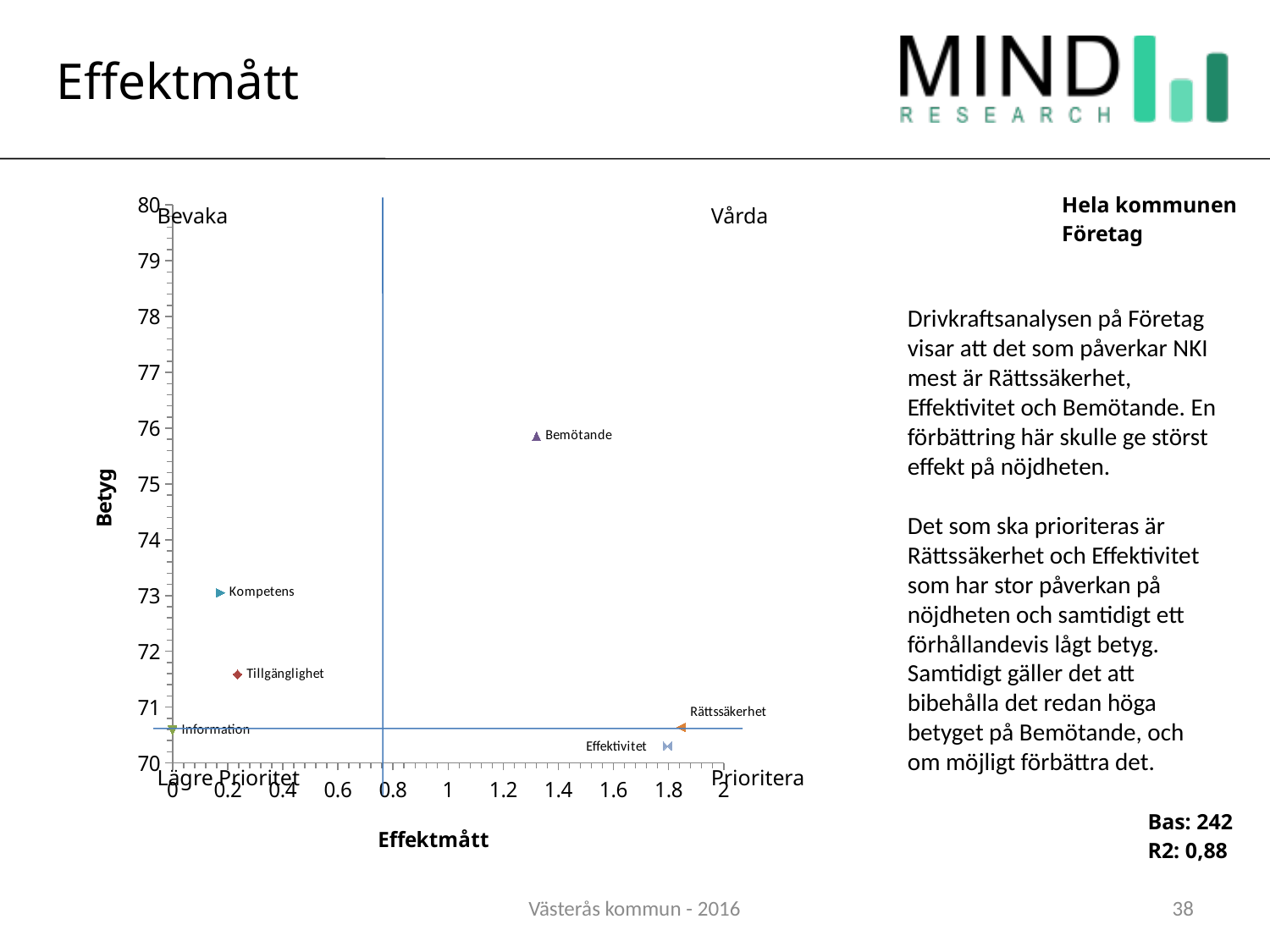
What label appears in the top-right quadrant of the chart? Vårda Is the Betyg value for Kompetens greater or less than 72? greater What is the title of the horizontal axis of the chart? Effektmått How many data points are plotted in the chart? 6 Which has a higher Betyg value, Bemötande or Kompetens? Bemötande Is the Betyg value for Bemötande greater or less than 75? greater What kind of chart is shown on the slide? scatter chart Is the Effektmått value for Bemötande greater or less than 1.2? greater Which point has the highest Betyg value? Bemötande Which point has the lowest Effektmått value? Information